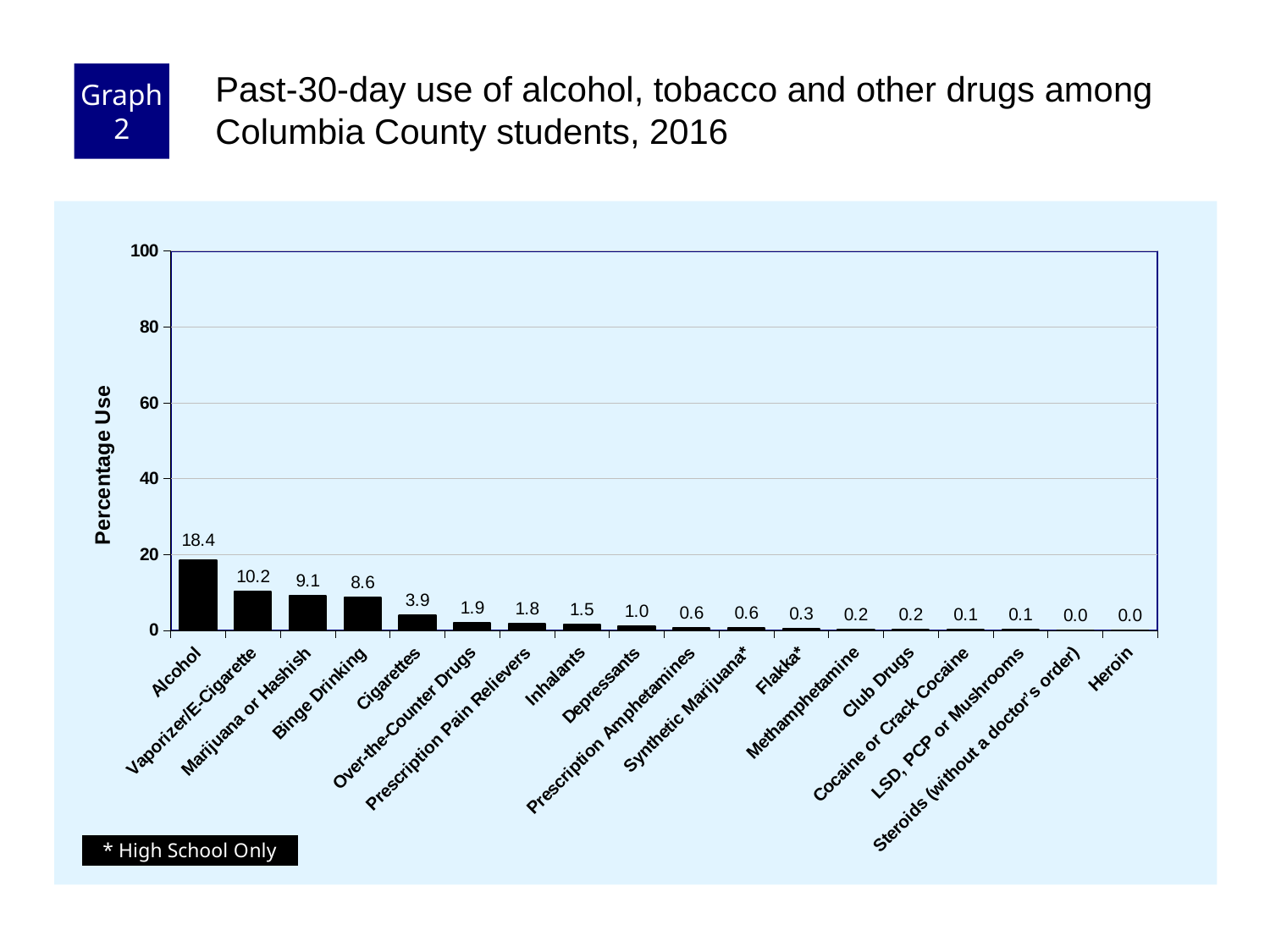
What is the difference in percentage use between Alcohol and Binge Drinking? 9.8 What type of chart is shown on the slide? Bar chart What is the label of the y axis? Percentage Use What is the percentage use shown for Heroin? 0.0 Which category has the highest percentage use? Alcohol How many categories are shown on the x axis? 18 What is the percentage use shown for Inhalants? 1.5 What is the percentage use shown for Vaporizer/E-Cigarette? 10.2 Which has a higher percentage use, Vaporizer/E-Cigarette or Marijuana or Hashish? Vaporizer/E-Cigarette What is the difference in percentage use between Marijuana or Hashish and Cigarettes? 5.2 What is the percentage use shown for Cigarettes? 3.9 What is the percentage use shown for Alcohol? 18.4